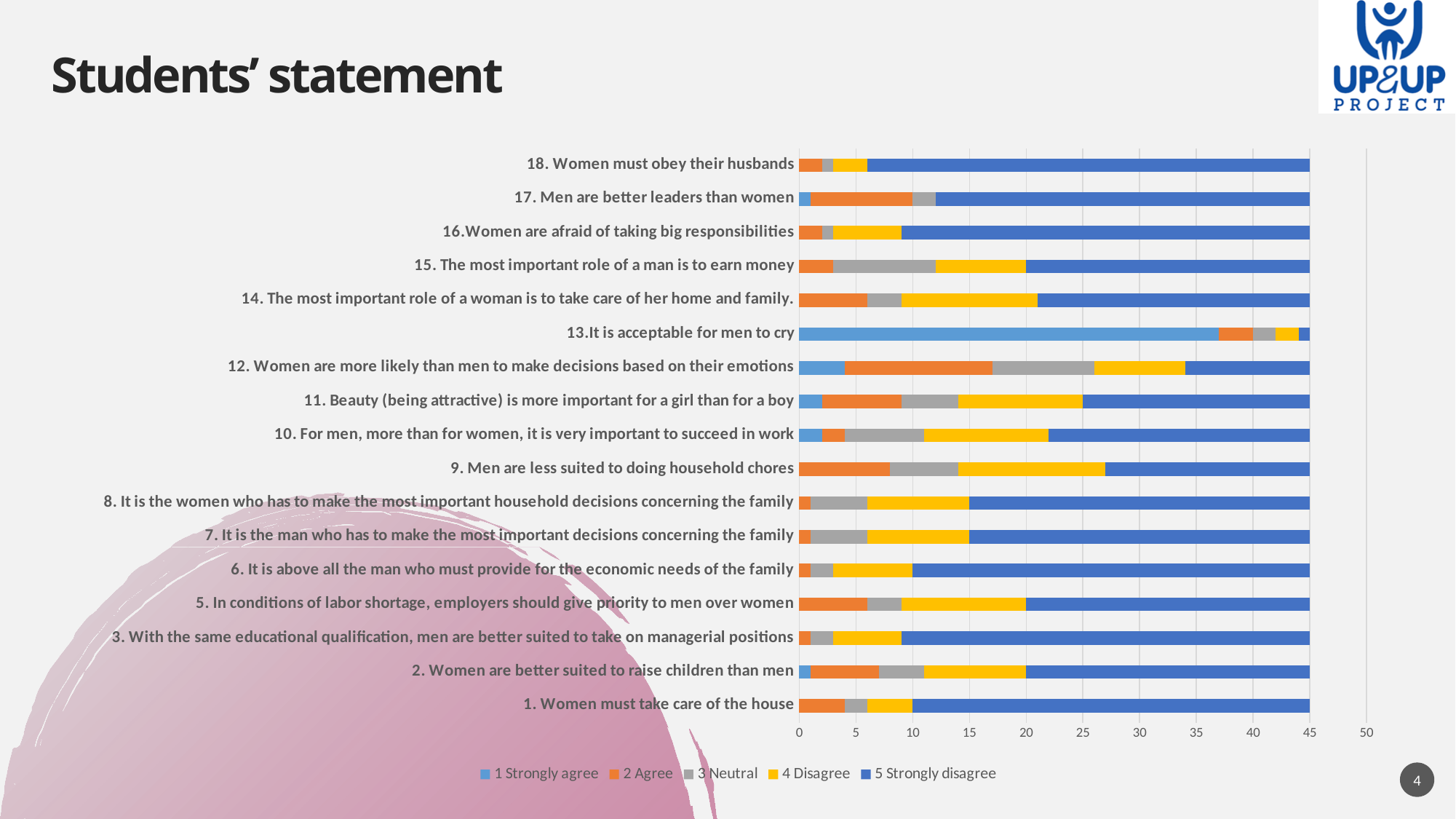
How many statements (categories) are plotted on the chart? 17 Is the '1 Strongly agree' value for statement 13 (It is acceptable for men to cry) greater or less than 35? greater Which statement has the largest '1 Strongly agree' segment? 13.It is acceptable for men to cry What kind of chart is shown on the slide? Stacked bar chart What is the title of the slide containing the chart? Students' statement How many series does the legend list? 5 Which statement has the largest '5 Strongly disagree' segment? 18. Women must obey their husbands What is the total of the stacked bar for statement 1 (Women must take care of the house)? 45 Is the '4 Disagree' value for statement 12 (Women are more likely than men to make decisions based on their emotions) greater or less than 10? less Which statement has the smallest '5 Strongly disagree' segment? 13.It is acceptable for men to cry Which has the larger '1 Strongly agree' value: statement 13 (It is acceptable for men to cry) or statement 12 (Women are more likely than men to make decisions based on their emotions)? 13.It is acceptable for men to cry Is the '5 Strongly disagree' value for statement 13 (It is acceptable for men to cry) greater or less than 5? less